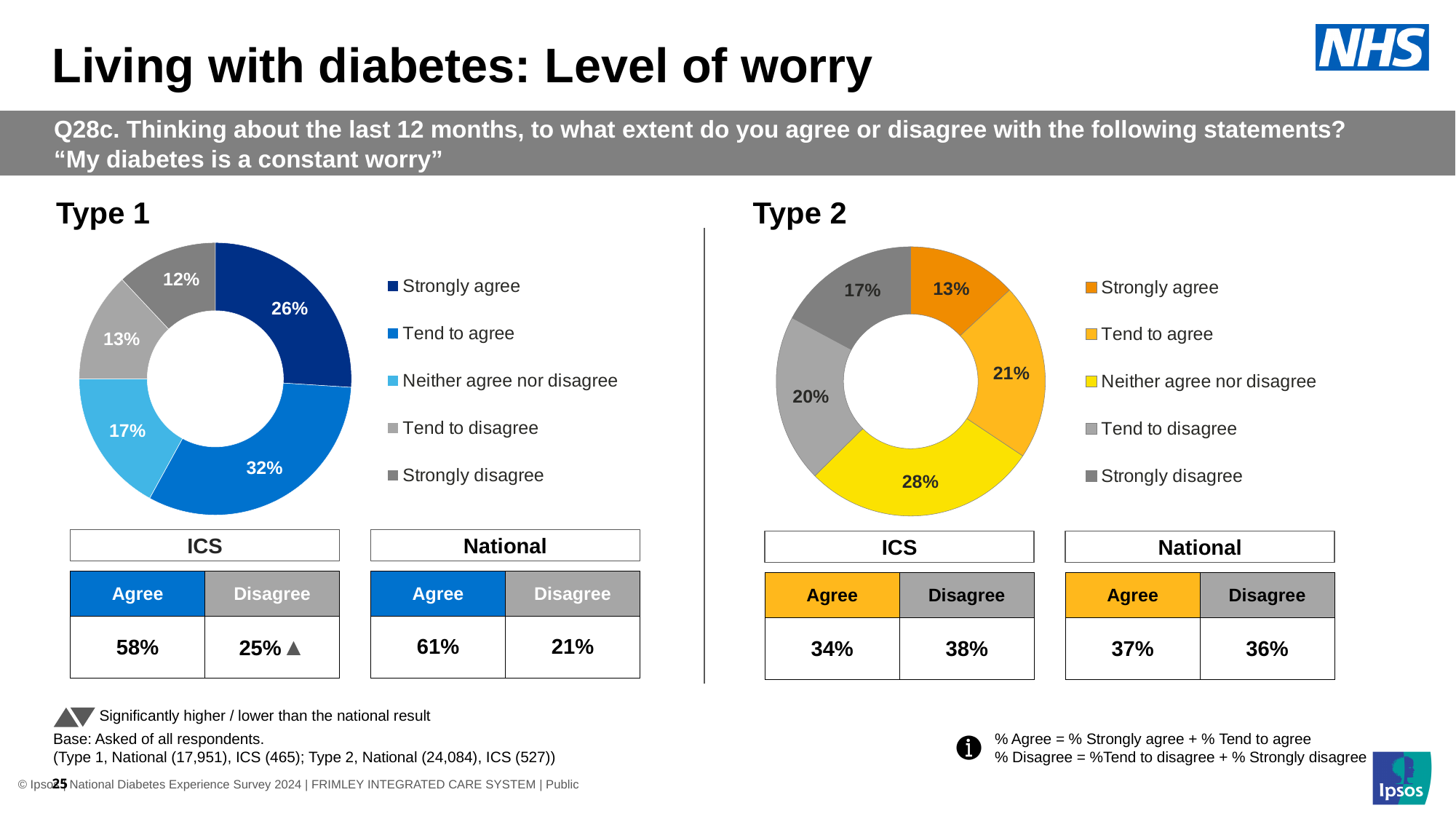
In the Type 2 chart, which response category has the smallest share? Strongly agree In the Type 1 chart, what is the difference between the Strongly agree and Strongly disagree shares? 14 percentage points In the Type 2 chart, what percentage of respondents neither agree nor disagree? 28% In the Type 1 chart, what percentage of respondents said they tend to agree? 32% In the Type 2 chart, which is larger: Tend to agree or Tend to disagree? Tend to agree In the Type 1 chart, what colour represents Strongly agree? Dark blue In the Type 1 chart, what percentage of respondents strongly disagree? 12% In the Type 2 chart, what percentage of respondents strongly agree? 13% In the Type 1 chart, which response category has the largest share? Tend to agree In the Type 2 chart, what is the difference between the Neither agree nor disagree and Strongly disagree shares? 11 percentage points What type of chart is used for the Type 1 data? Donut (pie) chart How many response categories does the Type 2 chart's legend list? 5